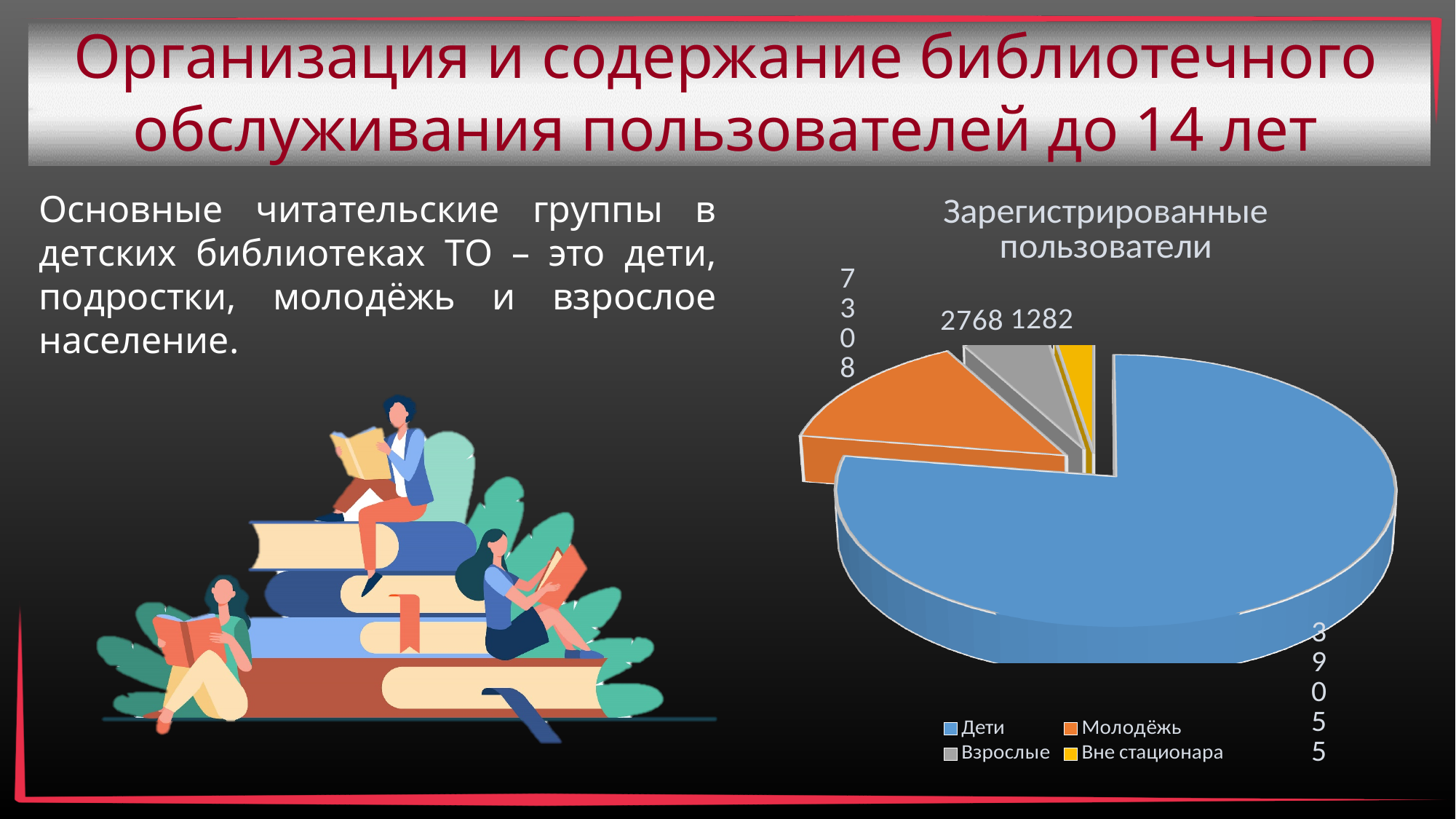
Which category has the largest slice in the pie chart? Дети What is the value for Вне стационара in the pie chart? 1282 What is the value for Молодёжь in the pie chart? 7308 What is the difference between the values for Дети and Молодёжь? 31747 Which is larger, the value for Взрослые or the value for Вне стационара? Взрослые Which category has the smallest slice in the pie chart? Вне стационара How many categories does the pie chart show? 4 What type of chart is shown on the slide? pie chart How many entries does the legend of the pie chart list? 4 What is the value for Дети in the pie chart? 39055 What is the value for Взрослые in the pie chart? 2768 What is the title of the chart on the slide? Зарегистрированные пользователи